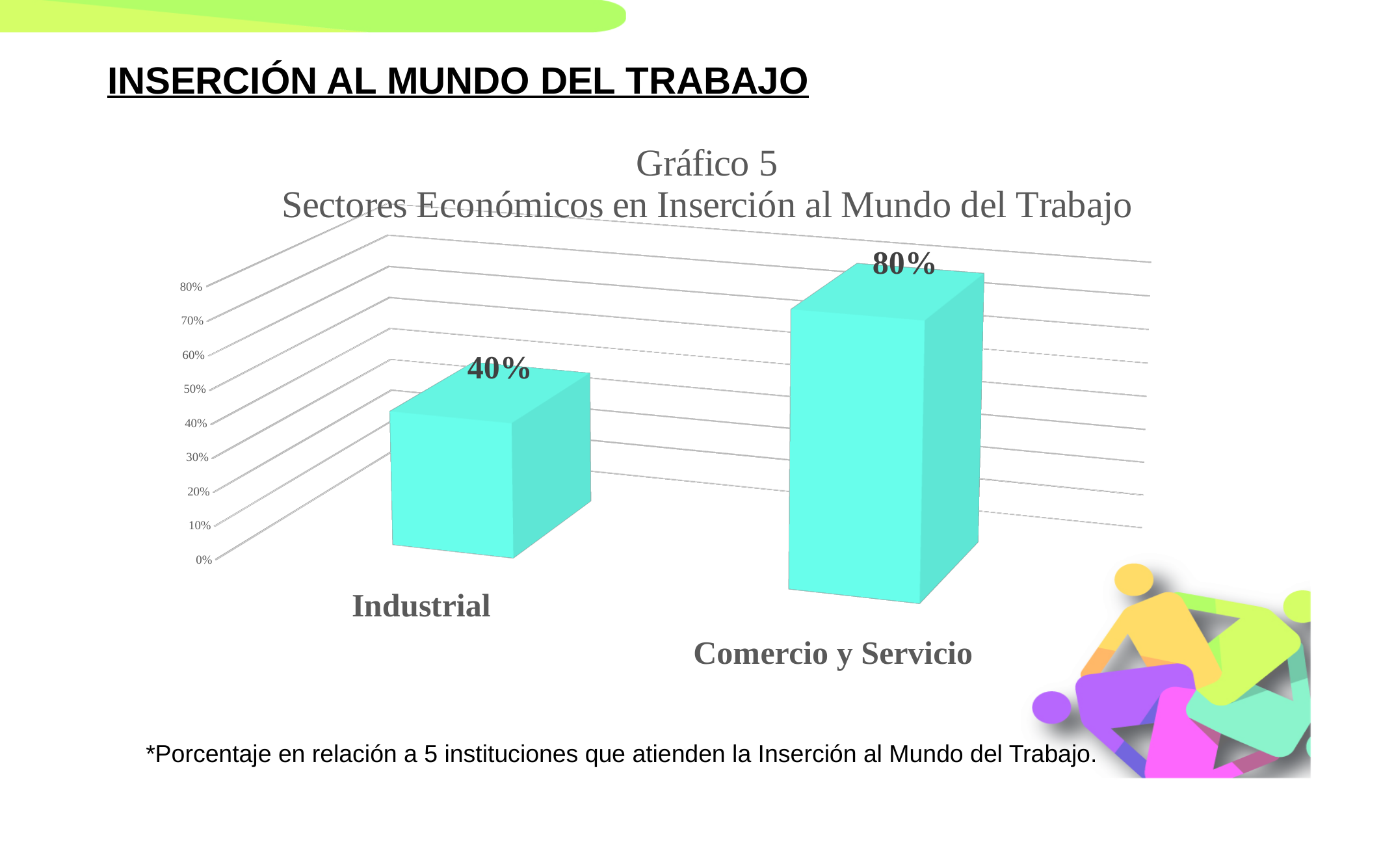
What is the title of the chart? Gráfico 5 Sectores Económicos en Inserción al Mundo del Trabajo Is the value for Comercio y Servicio greater or less than 60%? greater What is the value for Industrial? 40% Is the value for Industrial greater or less than 50%? less Which category has the highest value? Comercio y Servicio Which category has the lowest value? Industrial What kind of chart is shown on the slide? Bar chart How many categories are shown in the chart? 2 What is the value for Comercio y Servicio? 80% What is the highest value shown on the vertical axis? 80% What is the difference between the values for Comercio y Servicio and Industrial? 40% Which is larger, the value for Industrial or the value for Comercio y Servicio? Comercio y Servicio